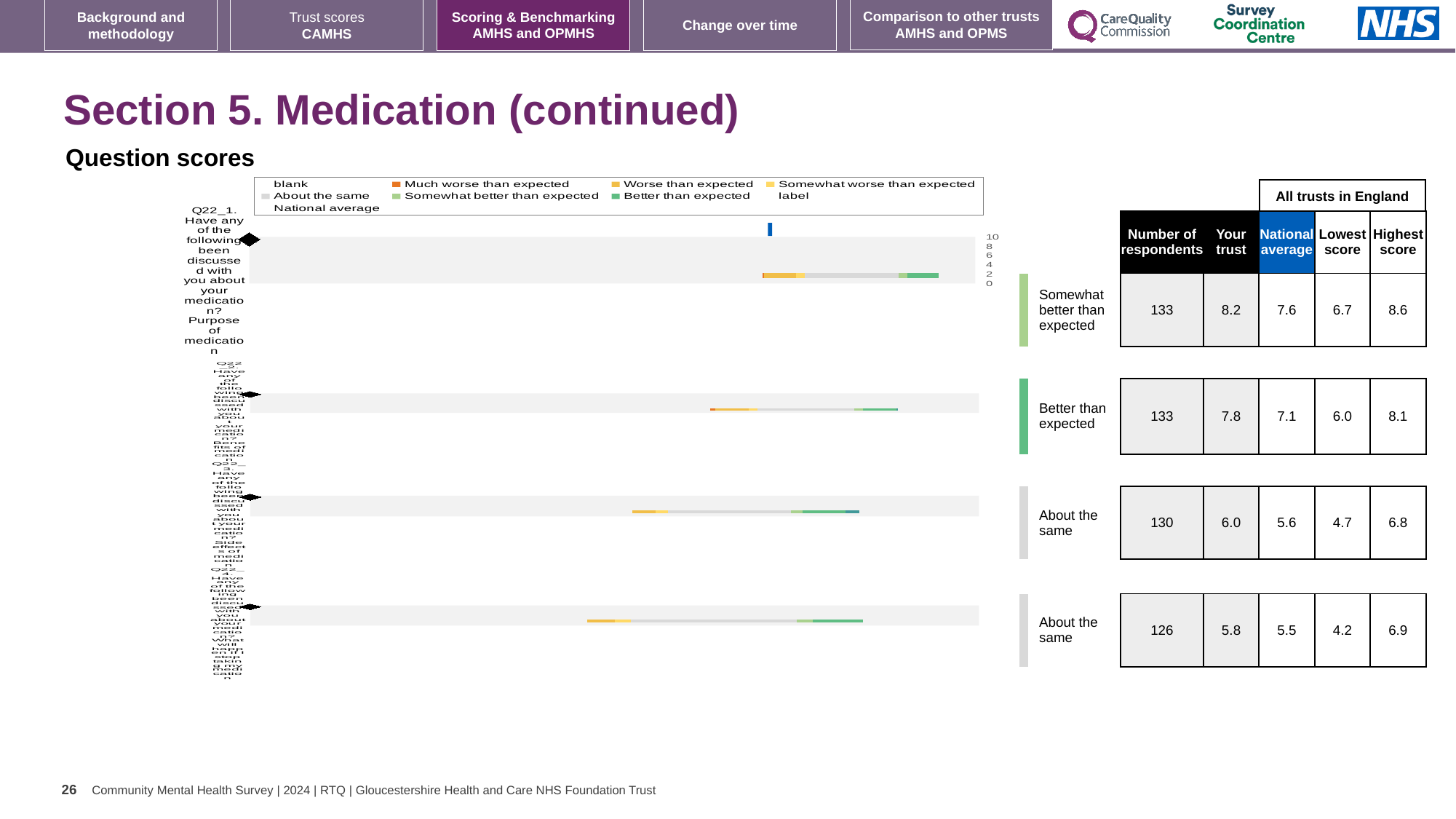
What kind of chart is shown under 'Question scores'? bar chart In the table next to the chart, which row has the highest 'Your trust' score? the first row (Somewhat better than expected), 8.2 How many horizontal bars are plotted in the question scores chart? 4 Which legend entry is shown with an orange colour in the chart legend? Much worse than expected In the table next to the chart, what is the national average for the second row (Better than expected)? 7.1 In the table next to the chart, for the fourth row, is the 'Your trust' score (5.8) or the national average (5.5) larger? Your trust (5.8) In the table next to the chart, what is the difference between the 'Your trust' score and the national average for the first row? 0.6 What is the maximum value shown on the chart's axis? 10 What benchmark label is shown beside the first bar (Q22_1) in the chart? Somewhat better than expected In the table next to the chart, what is the 'Your trust' score for the first row (Somewhat better than expected)? 8.2 What benchmark label is shown beside the third and fourth bars in the chart? About the same What benchmark label is shown beside the second bar in the chart? Better than expected